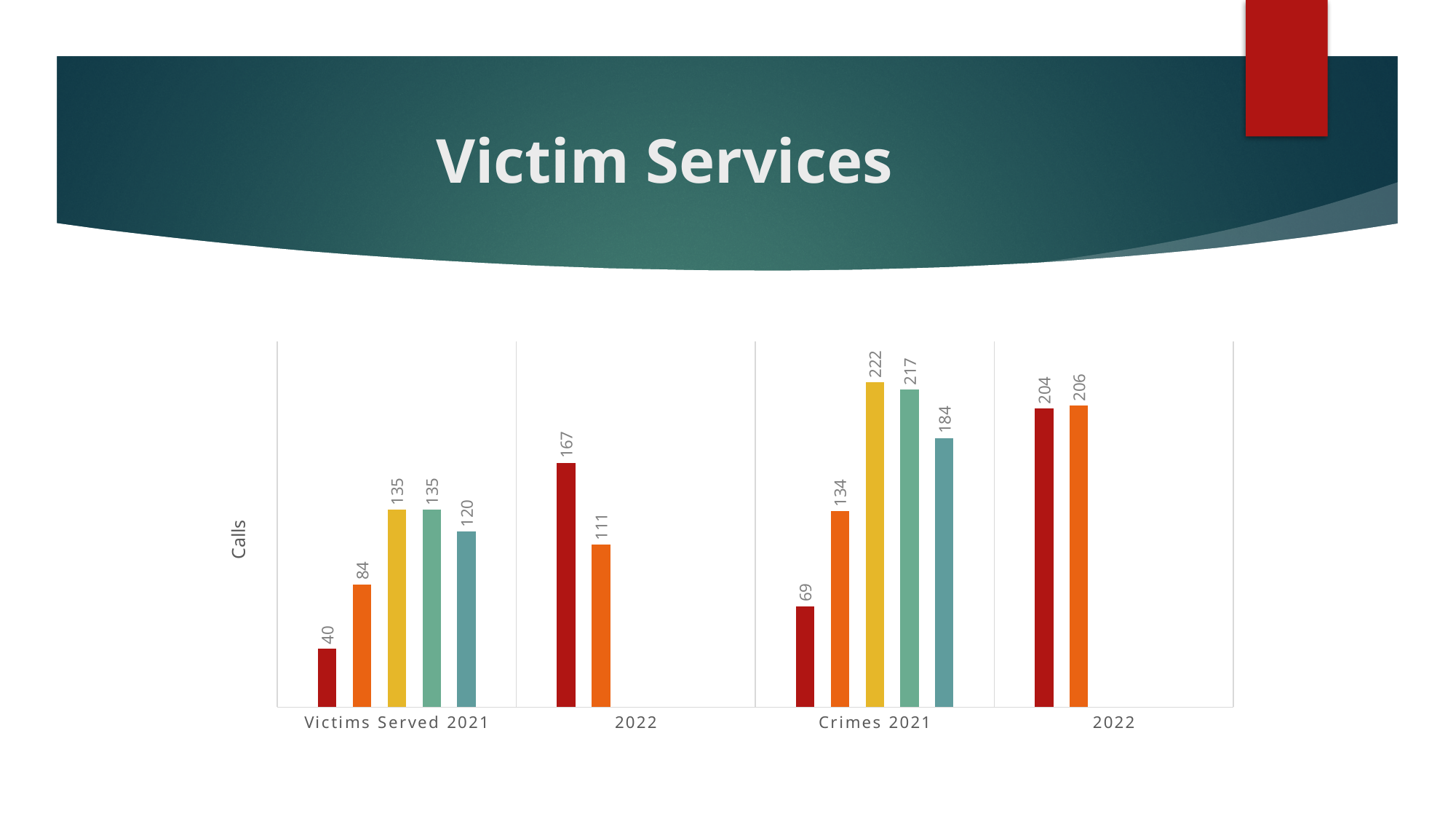
What kind of chart is shown on the slide? bar chart What is the difference between the dark red bar (167) and the orange bar (111) in the 2022 group next to Victims Served 2021? 56 Which bar has the lowest value in the Victims Served 2021 group? the dark red bar (40) How many categories are shown along the x axis of the chart? 4 What is the value of the first (dark red) bar in the Victims Served 2021 group? 40 Which bar has the highest value in the Crimes 2021 group? the yellow bar (222) What is the difference between the yellow bar (222) and the blue-teal bar (184) in the Crimes 2021 group? 38 What is the value of the orange bar in the Crimes 2021 group? 134 What is the value of the orange bar in the 2022 group next to Crimes 2021? 206 What is the label on the vertical axis of the chart? Calls What is the value of the dark red bar in the 2022 group next to Victims Served 2021? 167 Which is larger: the yellow bar in Crimes 2021 or the yellow bar in Victims Served 2021? the yellow bar in Crimes 2021 (222)